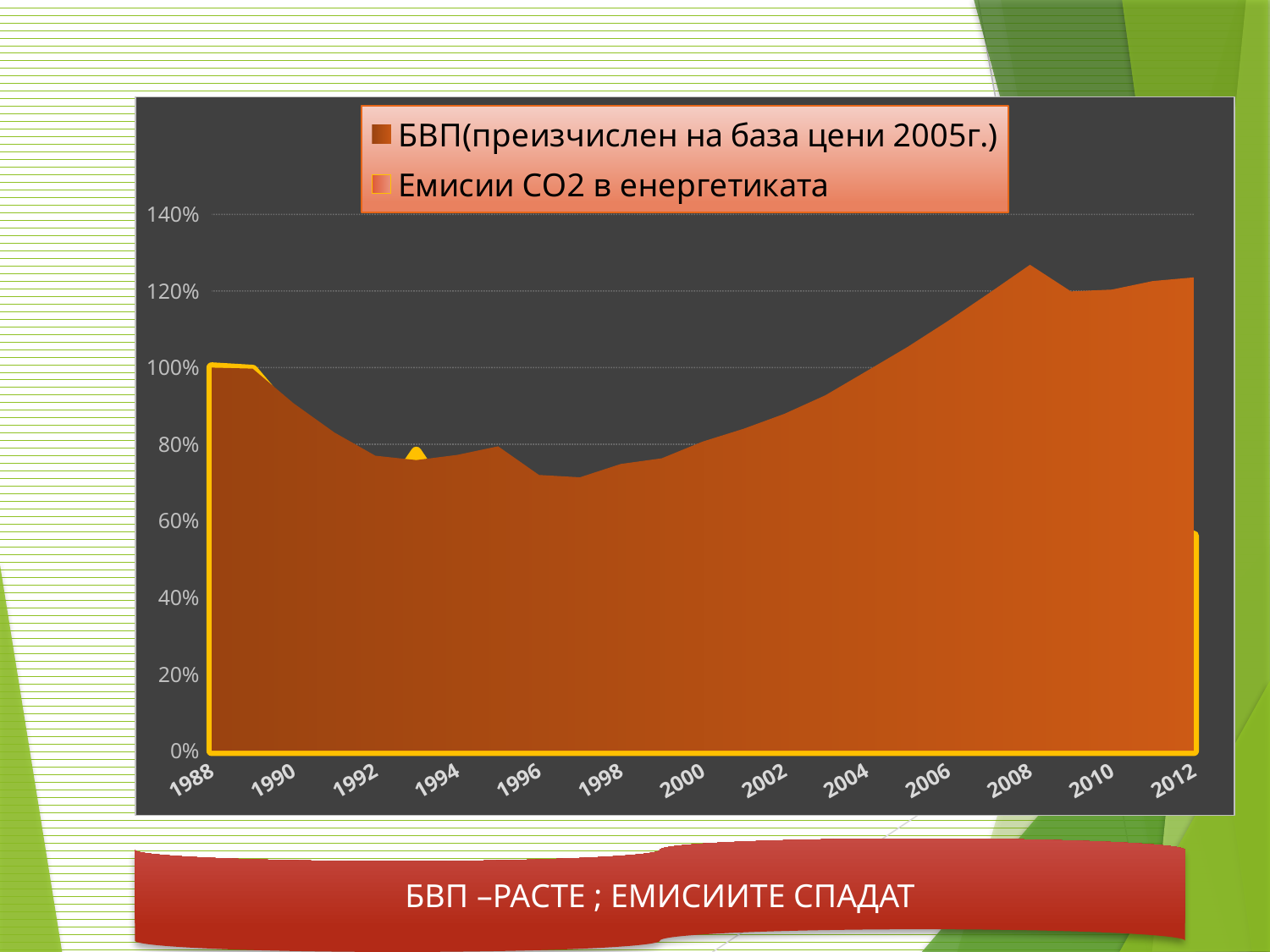
In which year does the БВП series reach its highest value? 2008 What is the first year shown on the x axis? 1988 Is the value of Емисии CO2 в енергетиката in 2012 greater or less than 80%? less What are the two series named in the legend? БВП(преизчислен на база цени 2005г.) and Емисии CO2 в енергетиката What kind of chart is shown on the slide? area chart How many series does the legend list? 2 Is the value of БВП in 2008 greater or less than 120%? greater Is the value of БВП in 1997 greater or less than 80%? less How many year labels are shown on the x axis? 13 Does the БВП series rise or fall between 1998 and 2008? rise Which series has the larger value in 2012, БВП or Емисии CO2 в енергетиката? БВП